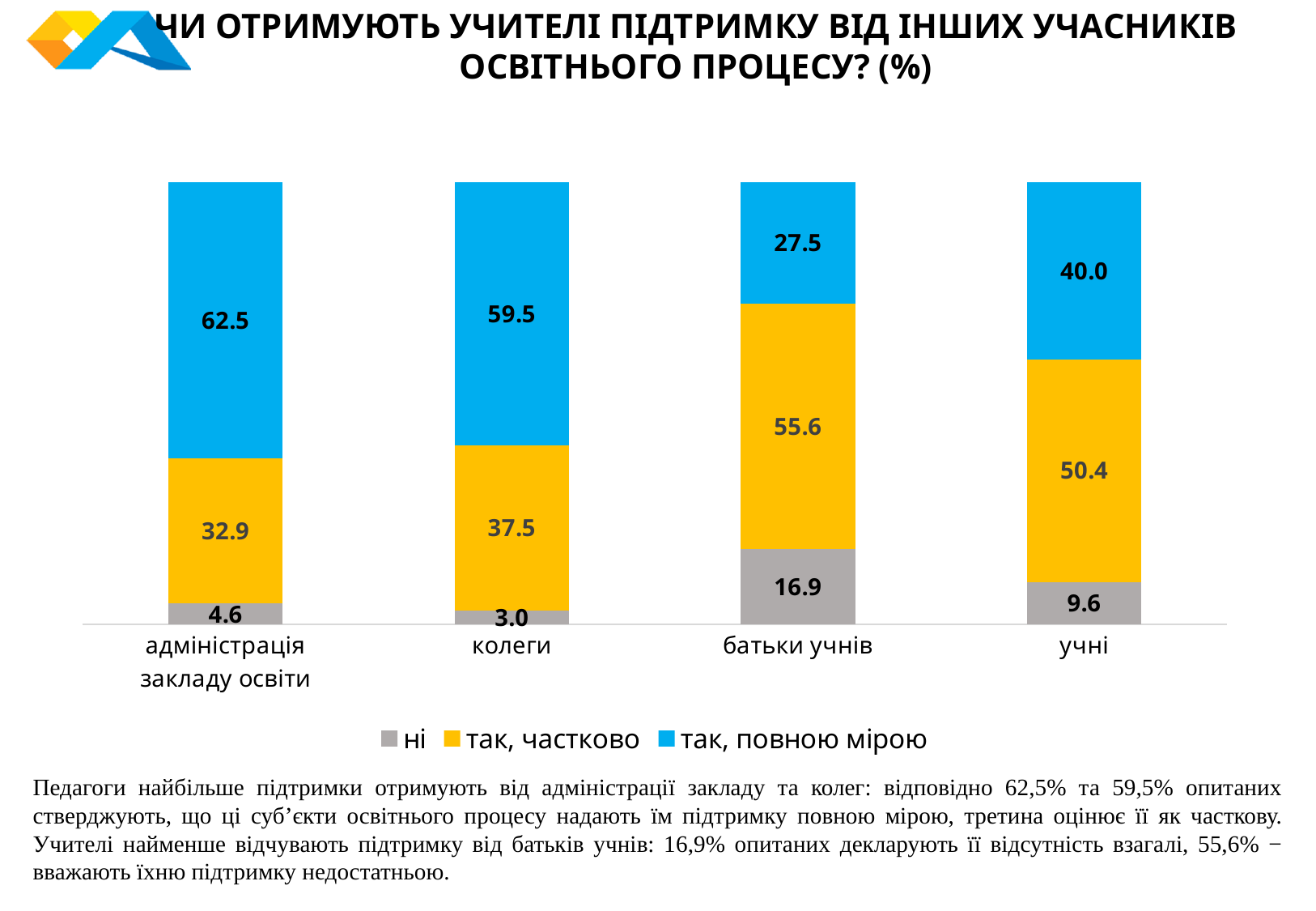
What is the value of "так, частково" for "учні"? 50.4 What type of chart is shown on the slide? stacked bar chart What is the total of the stacked bar for "колеги"? 100.0 Which category has the highest value for "так, частково"? батьки учнів How many categories are shown on the x axis of the chart? 4 What is the difference between the "так, повною мірою" values for "адміністрація закладу освіти" and "колеги"? 3.0 What is the value of "ні" for "батьки учнів"? 16.9 What is the value of "так, повною мірою" for "адміністрація закладу освіти"? 62.5 Which category has the lowest value for "ні"? колеги Which is larger: the "так, повною мірою" value for "учні" or for "батьки учнів"? учні How many series does the legend list? 3 Which colour represents the series "ні" in the legend? grey